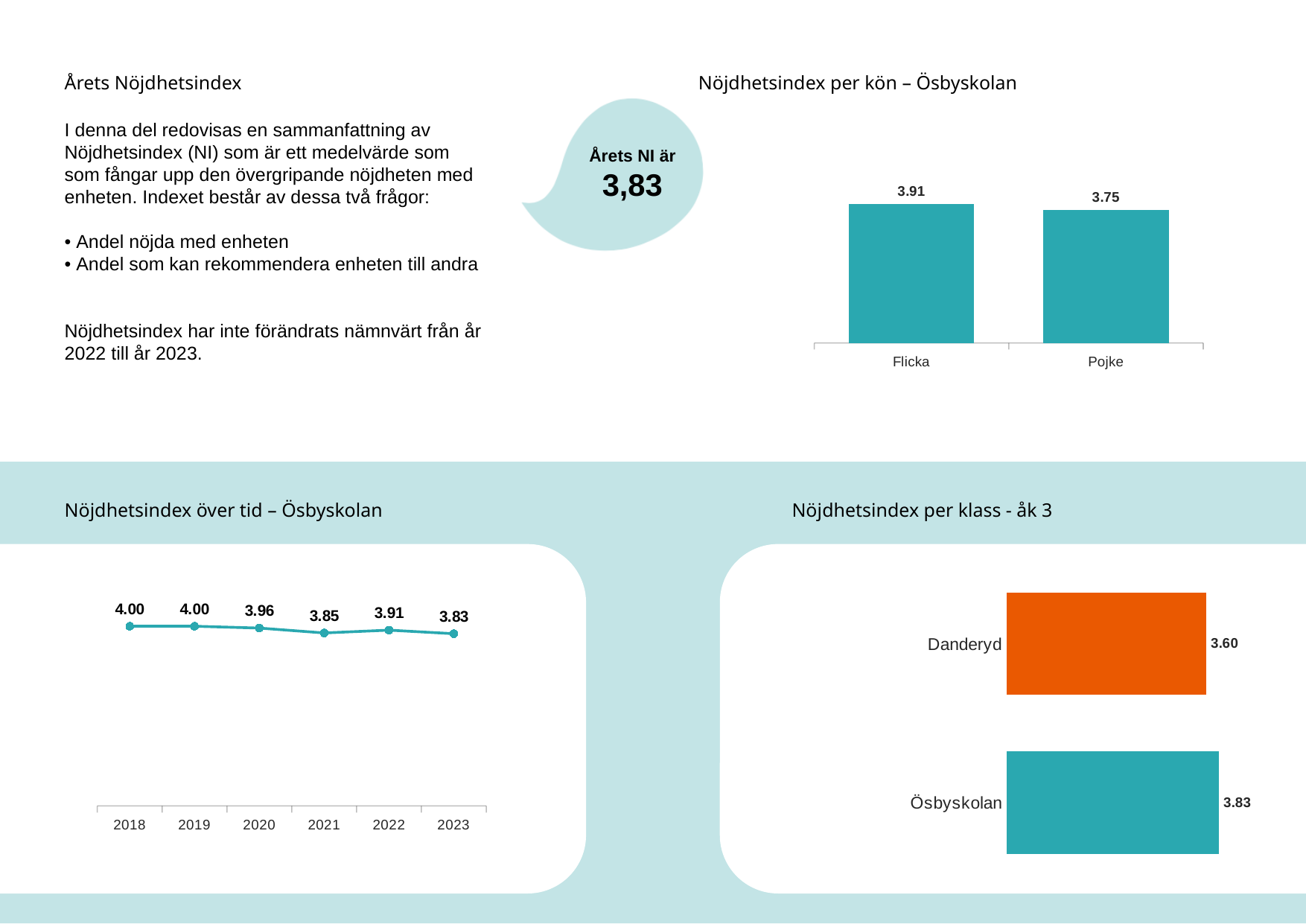
In the 'Nöjdhetsindex per kön – Ösbyskolan' chart, what is the difference between Flicka and Pojke? 0.16 What kind of chart is 'Nöjdhetsindex över tid – Ösbyskolan'? Line chart In the 'Nöjdhetsindex per klass - åk 3' chart, what is the value for Danderyd? 3.60 In the 'Nöjdhetsindex per kön – Ösbyskolan' chart, what is the value for Flicka? 3.91 In the 'Nöjdhetsindex över tid – Ösbyskolan' chart, what is the value for 2021? 3.85 How many years are plotted in the 'Nöjdhetsindex över tid – Ösbyskolan' chart? 6 In the 'Nöjdhetsindex per kön – Ösbyskolan' chart, what is the value for Pojke? 3.75 In the 'Nöjdhetsindex över tid – Ösbyskolan' chart, what is the value for 2023? 3.83 What kind of chart is 'Nöjdhetsindex per kön – Ösbyskolan'? Bar chart In the 'Nöjdhetsindex över tid – Ösbyskolan' chart, which year has the lowest value? 2023 In the 'Nöjdhetsindex per klass - åk 3' chart, which is larger, Danderyd or Ösbyskolan? Ösbyskolan In the 'Nöjdhetsindex per kön – Ösbyskolan' chart, which category has the higher value? Flicka